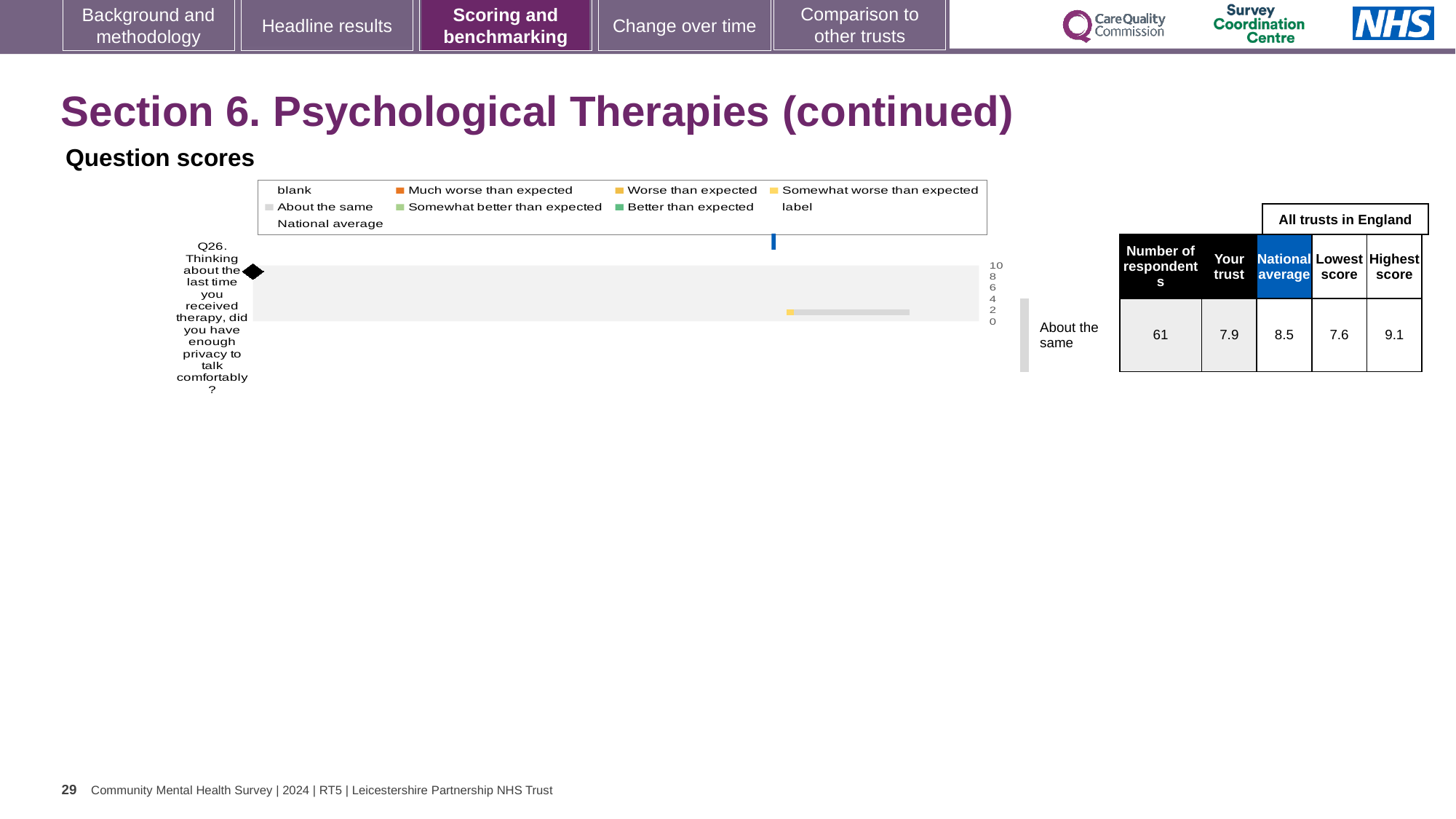
What is the lowest score among all trusts in England for Q26? 7.6 What is the 'Your trust' score for Q26? 7.9 How many respondents answered Q26? 61 For Q26, which is higher: the trust's score or the national average? National average What is the highest score among all trusts in England for Q26? 9.1 Which question number is plotted in the Question scores chart? Q26 Which benchmark category is Q26 placed in? About the same What kind of chart is used to show the Q26 question score? bar chart What is the national average score for Q26? 8.5 What is the difference between the highest and lowest trust scores for Q26? 1.5 How many survey questions are plotted in the Question scores chart? 1 What is the maximum value shown on the score axis of the chart? 10